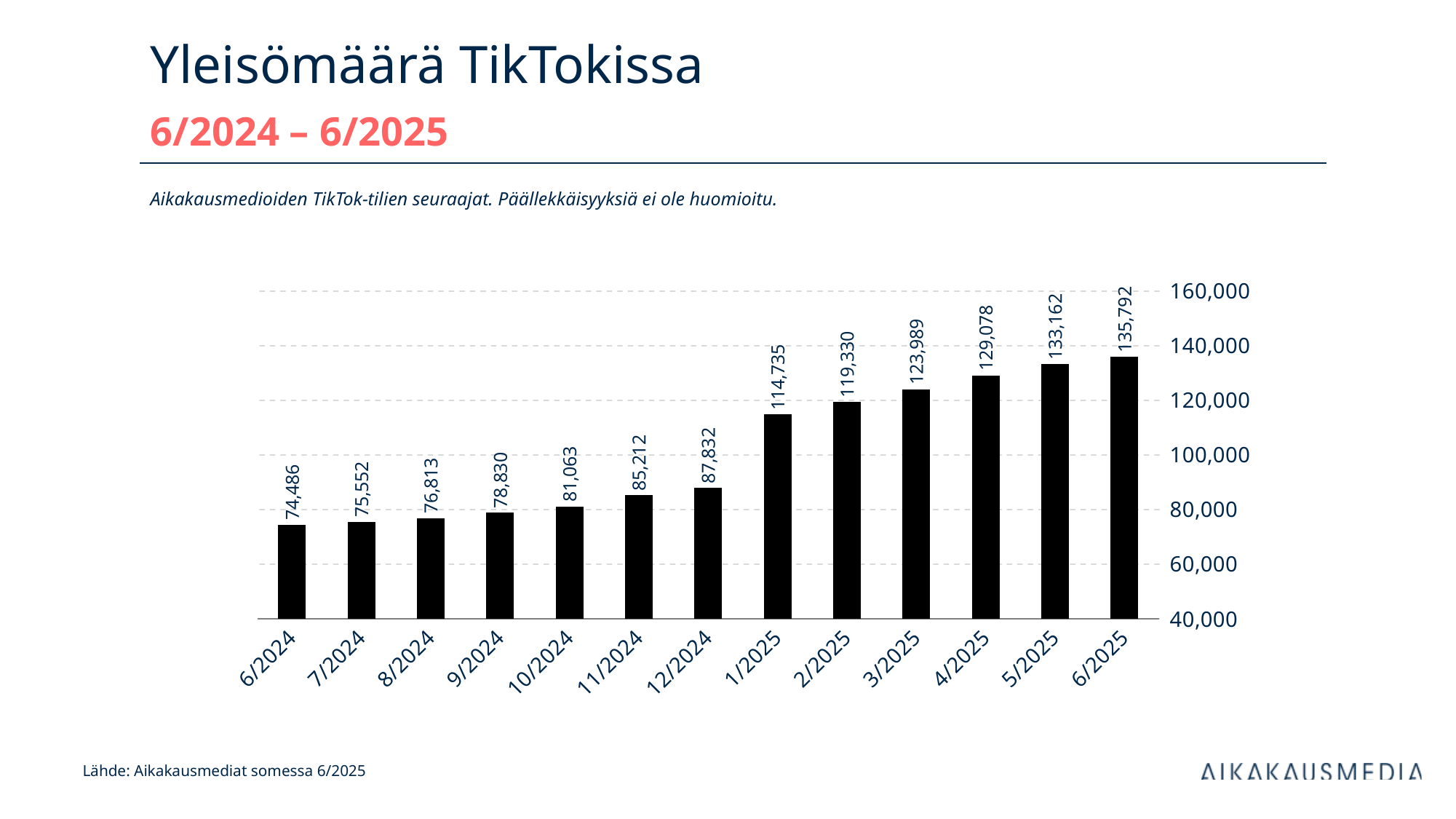
Which is larger, the value for 3/2025 or the value for 11/2024? 3/2025 What is the value for 6/2024? 74,486 Which month has the highest value? 6/2025 Do the values rise or fall from 6/2024 to 6/2025? rise Which month has the lowest value? 6/2024 What is the difference between the values for 6/2025 and 6/2024? 61,306 What kind of chart is shown on the slide? bar chart What is the value for 1/2025? 114,735 What is the value for 6/2025? 135,792 How many months are shown on the x axis? 13 Is the value for 2/2025 greater or less than 100,000? greater What is the difference between the values for 1/2025 and 12/2024? 26,903